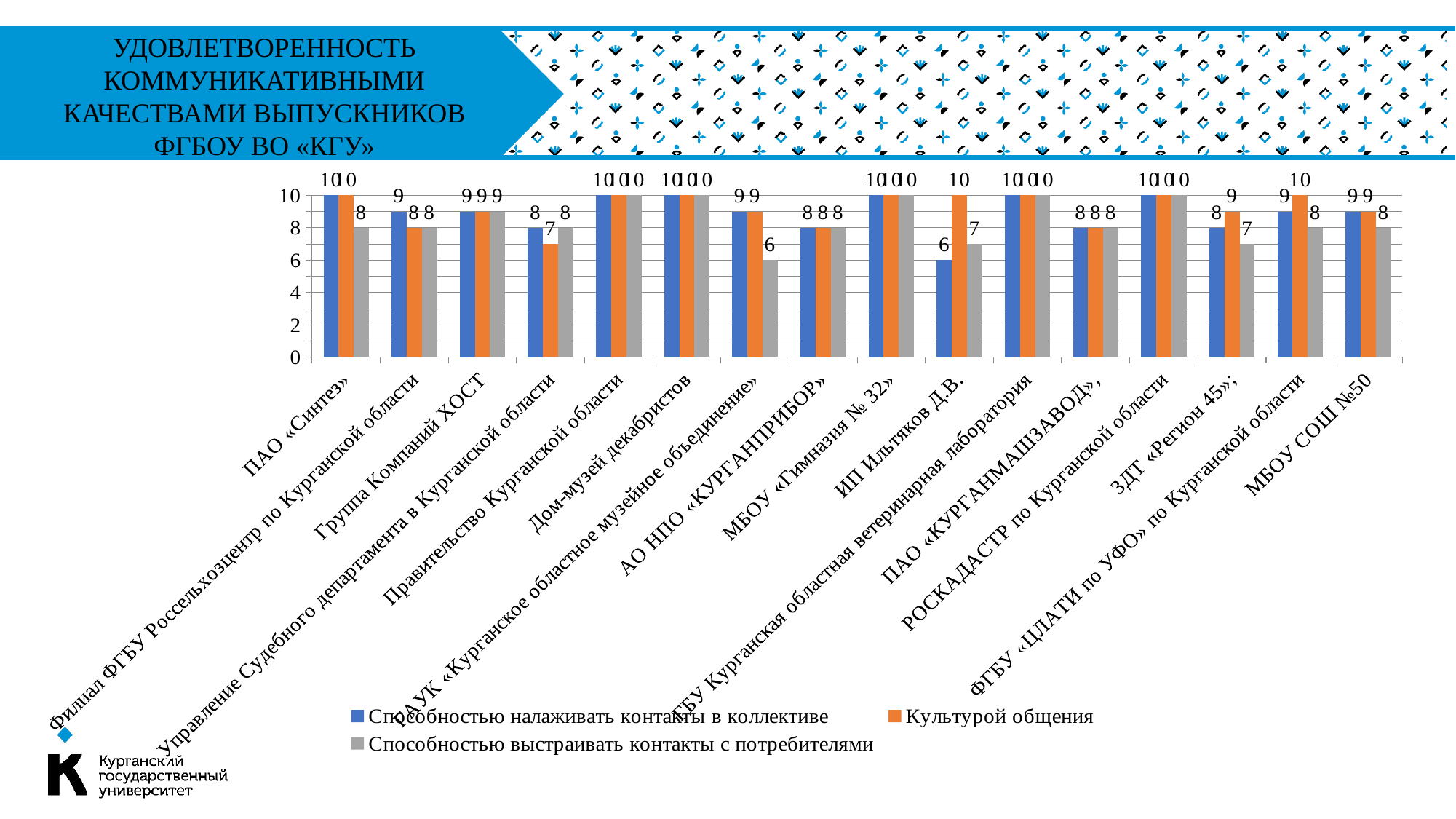
What is the value of «Способностью налаживать контакты в коллективе» for ИП Ильтяков Д.В.? 6 What type of chart is shown on the slide? bar chart How many organisations (categories) are shown on the x axis? 16 What is the value of «Культурой общения» for Управление Судебного департамента в Курганской области? 7 What is the value of «Способностью выстраивать контакты с потребителями» for ГАУК «Курганское областное музейное объединение»? 6 Which colour represents «Культурой общения» in the legend? orange What is the value of «Способностью выстраивать контакты с потребителями» for ПАО «Синтез»? 8 What is the value of «Культурой общения» for ИП Ильтяков Д.В.? 10 How many series does the legend list? 3 What is the difference between «Культурой общения» and «Способностью налаживать контакты в коллективе» for ИП Ильтяков Д.В.? 4 Which organisation has the lowest value for «Способностью налаживать контакты в коллективе»? ИП Ильтяков Д.В. For ЗДТ «Регион 45», which is larger: «Культурой общения» or «Способностью выстраивать контакты с потребителями»? Культурой общения